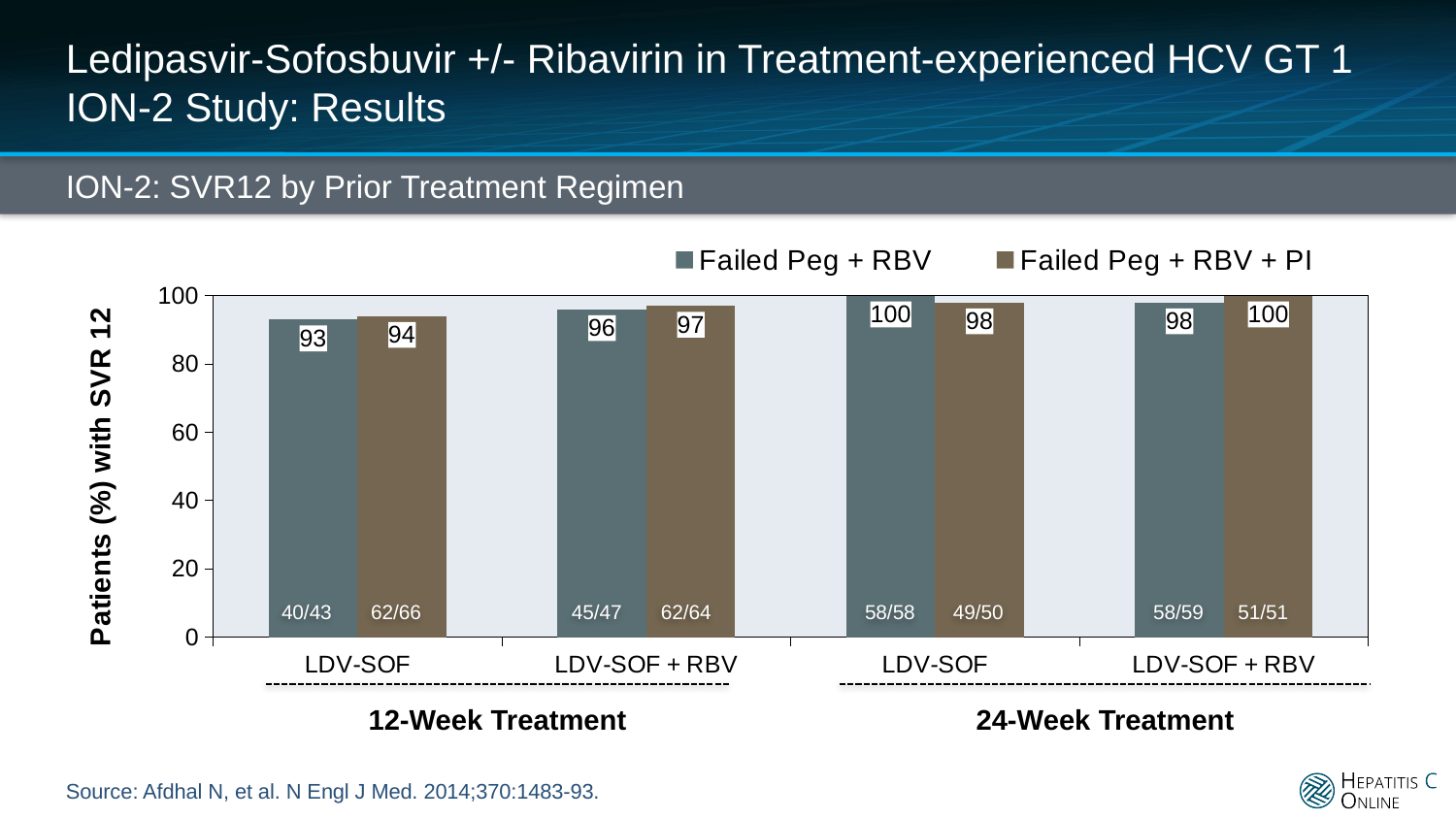
In the 12-Week Treatment arm with LDV-SOF, which group has the higher SVR12 rate: Failed Peg + RBV or Failed Peg + RBV + PI? Failed Peg + RBV + PI How many series does the legend list? 2 Which bar has the lowest SVR12 rate on the chart? Failed Peg + RBV, LDV-SOF, 12-Week Treatment What is the SVR12 rate for the Failed Peg + RBV group with LDV-SOF in the 12-Week Treatment arm? 93 How many treatment regimen categories are shown along the x axis? 4 What is the difference in SVR12 rate between the Failed Peg + RBV + PI group and the Failed Peg + RBV group for LDV-SOF in the 24-Week Treatment arm? 2 What fraction of patients is shown for the Failed Peg + RBV + PI group with LDV-SOF + RBV in the 24-Week Treatment arm? 51/51 What is the label of the y axis? Patients (%) with SVR 12 What fraction of patients is shown for the Failed Peg + RBV group with LDV-SOF + RBV in the 12-Week Treatment arm? 45/47 What is the SVR12 rate for the Failed Peg + RBV + PI group with LDV-SOF + RBV in the 12-Week Treatment arm? 97 What is the SVR12 rate for the Failed Peg + RBV group with LDV-SOF in the 24-Week Treatment arm? 100 What kind of chart is shown on the slide? Bar chart